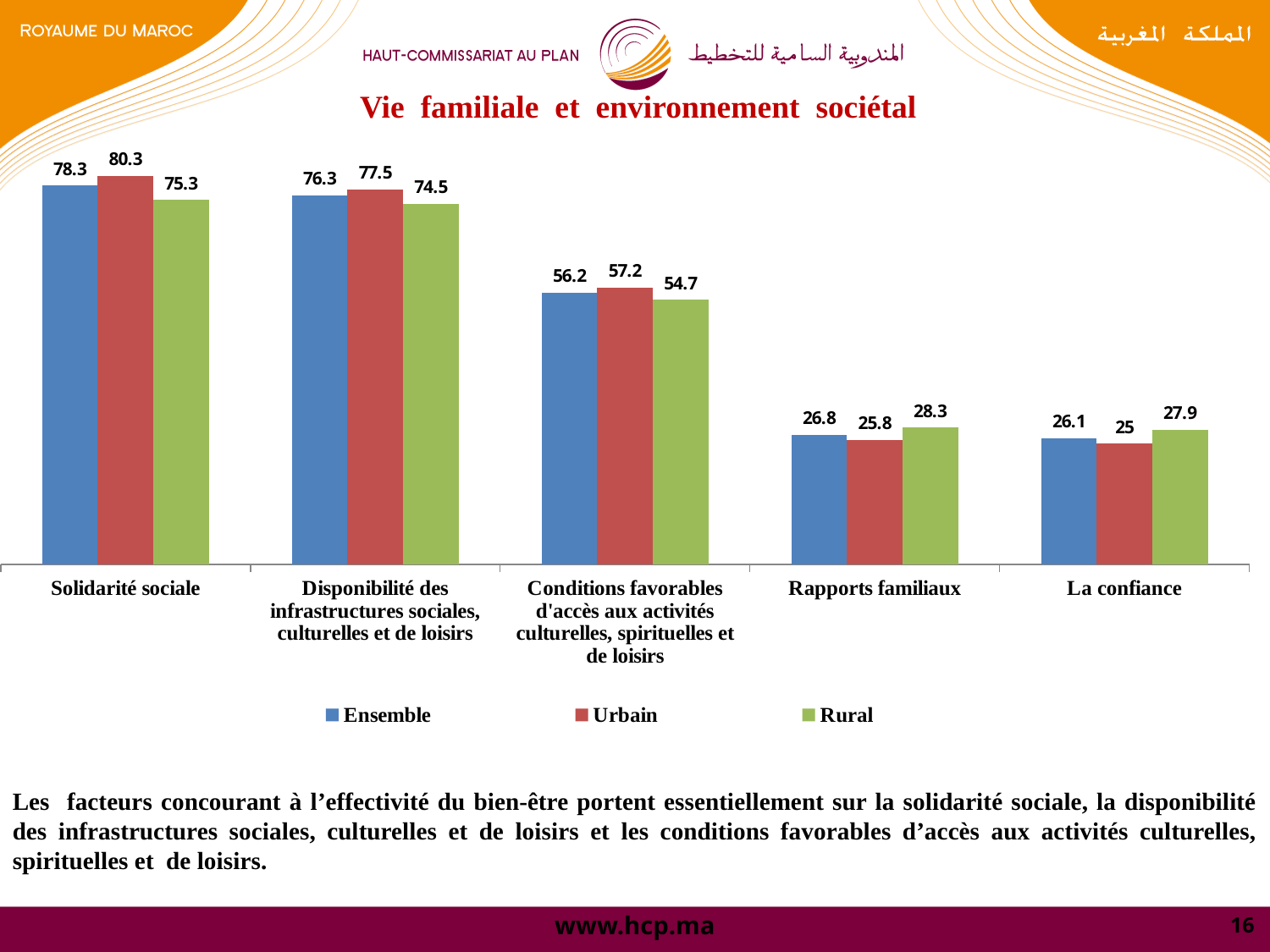
What is the Ensemble value for La confiance? 26.1 For Rapports familiaux, which is larger: the Ensemble value or the Rural value? Rural Which category has the lowest Urbain value? La confiance What kind of chart is shown on the slide? Bar chart What is the Rural value for Conditions favorables d'accès aux activités culturelles, spirituelles et de loisirs? 54.7 What is the difference between the Rural and Urbain values for Rapports familiaux? 2.5 What is the difference between the Urbain and Rural values for Solidarité sociale? 5 How many categories are shown on the x axis? 5 Which category has the highest Ensemble value? Solidarité sociale What is the Urbain value for Solidarité sociale? 80.3 How many series does the legend list? 3 Which colour represents the Rural series in the legend? Green